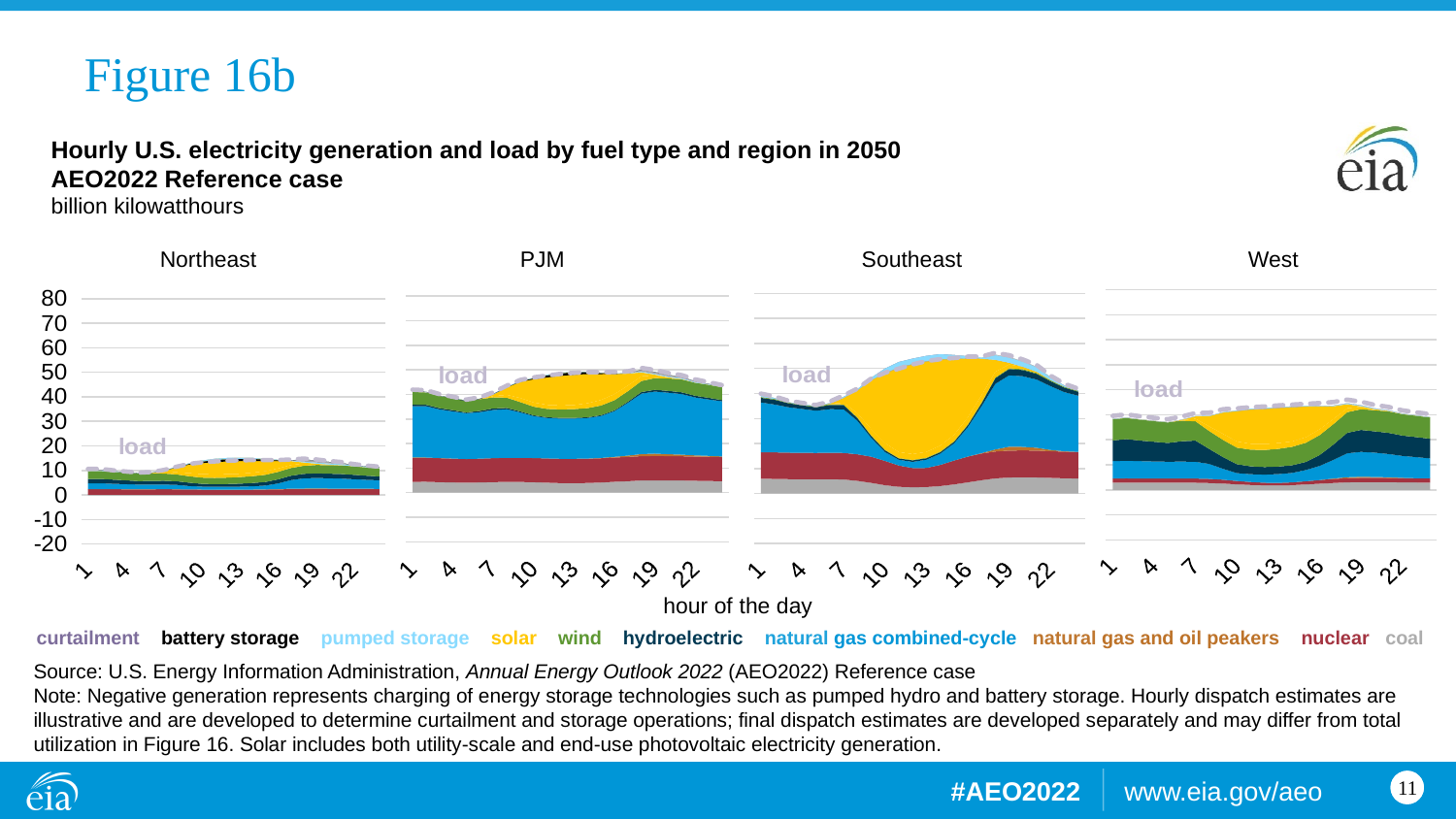
What is the label of the shared x axis? hour of the day In the Southeast chart, is the peak generation greater or less than 50? greater In the Southeast chart, does total generation rise or fall between hour 7 and hour 13? rise Which region's chart shows the highest peak generation? Southeast In the Northeast chart, is the peak load greater or less than 20? less In the West chart, is the peak generation greater or less than 30? greater Which region's chart shows the lowest peak generation? Northeast Is the peak generation in the Southeast chart larger or smaller than the peak generation in the Northeast chart? larger What kind of chart is used for each region on this slide? stacked area chart How many regional charts are shown on the slide? 4 What unit is used for the y axis of the charts? billion kilowatthours How many fuel-type series does the legend list? 10